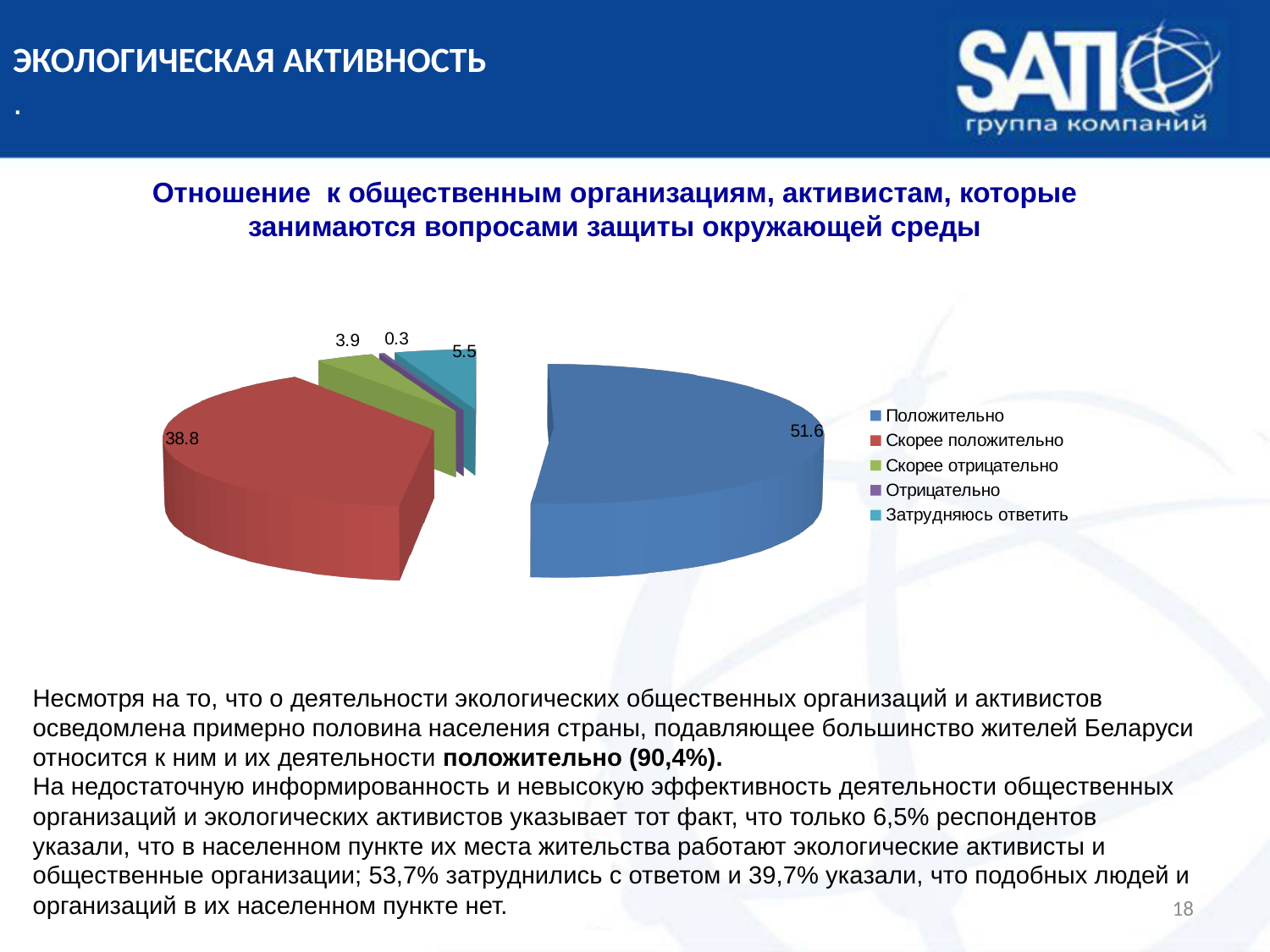
What kind of chart is shown on the slide? Pie chart What is the value for "Скорее отрицательно"? 3.9 What is the difference between the values for "Положительно" and "Скорее положительно"? 12.8 What is the value for "Отрицательно"? 0.3 What is the value for "Затрудняюсь ответить"? 5.5 Which category has the largest slice of the pie? Положительно How many categories does the legend of the pie chart list? 5 What colour is the slice for "Скорее положительно"? Red Which is larger, the value for "Затрудняюсь ответить" or the value for "Скорее отрицательно"? Затрудняюсь ответить What is the value for "Положительно"? 51.6 What is the value for "Скорее положительно"? 38.8 Which category has the smallest slice of the pie? Отрицательно